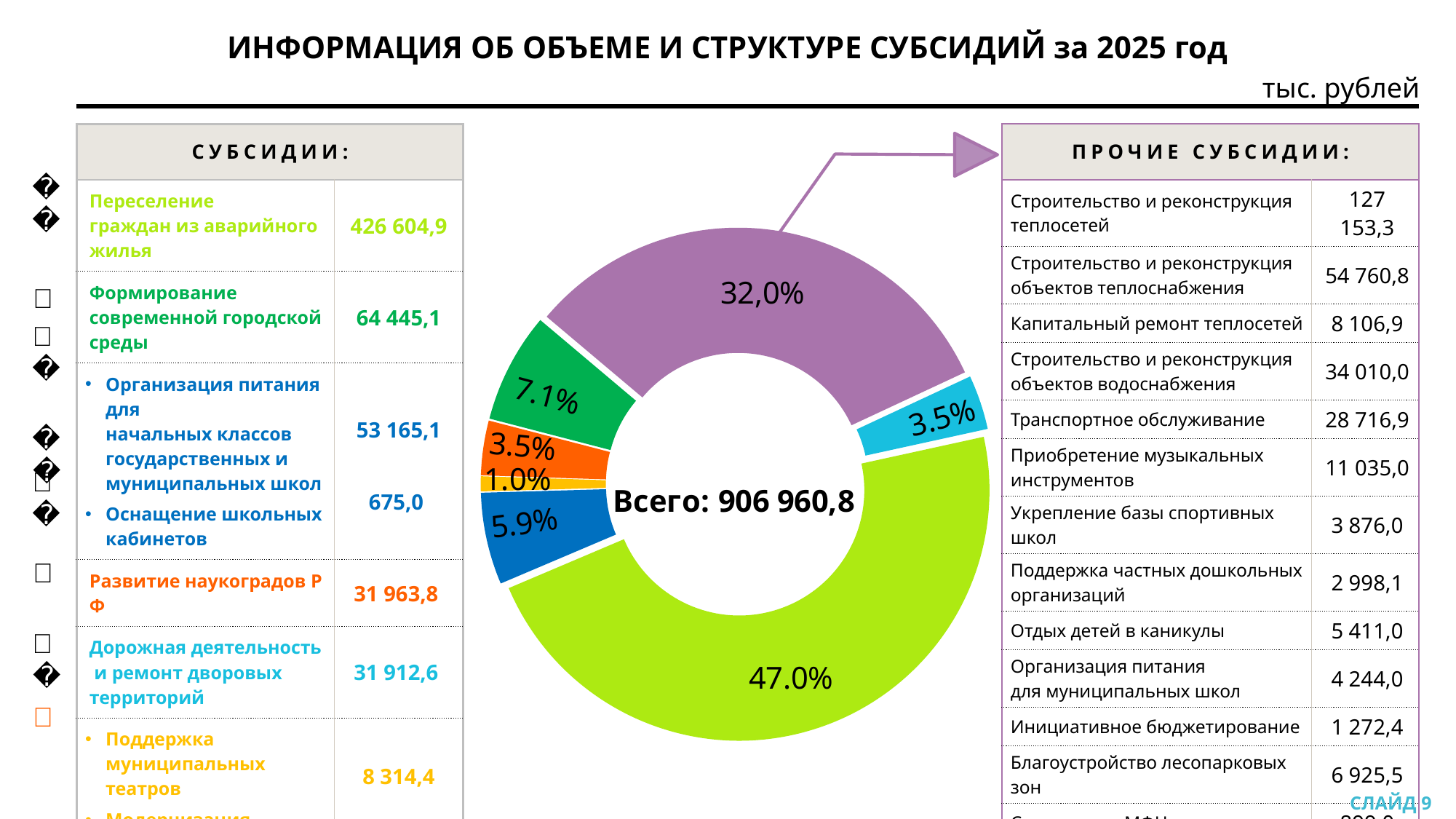
What is the smallest percentage shown on the donut chart? 1.0% What total value is printed in the centre of the donut chart? Всего: 906 960,8 What is the difference in percentage points between the largest slice (47.0%) and the purple slice (32,0%)? 15.0 percentage points What is the largest percentage shown on the donut chart? 47.0% What kind of chart is shown in the centre of the slide? Pie (donut) chart What percentage is shown on the dark blue slice of the donut chart? 5.9% What percentage is shown on the dark green slice of the donut chart? 7.1% Which is larger on the donut chart: the dark green slice or the dark blue slice? The dark green slice (7.1%) Which table does the arrow from the purple slice of the donut chart point to? ПРОЧИЕ СУБСИДИИ How many slices does the donut chart have? 7 What percentage is shown on the purple slice of the donut chart? 32,0% What unit is stated at the top right of the slide for the values? тыс. рублей